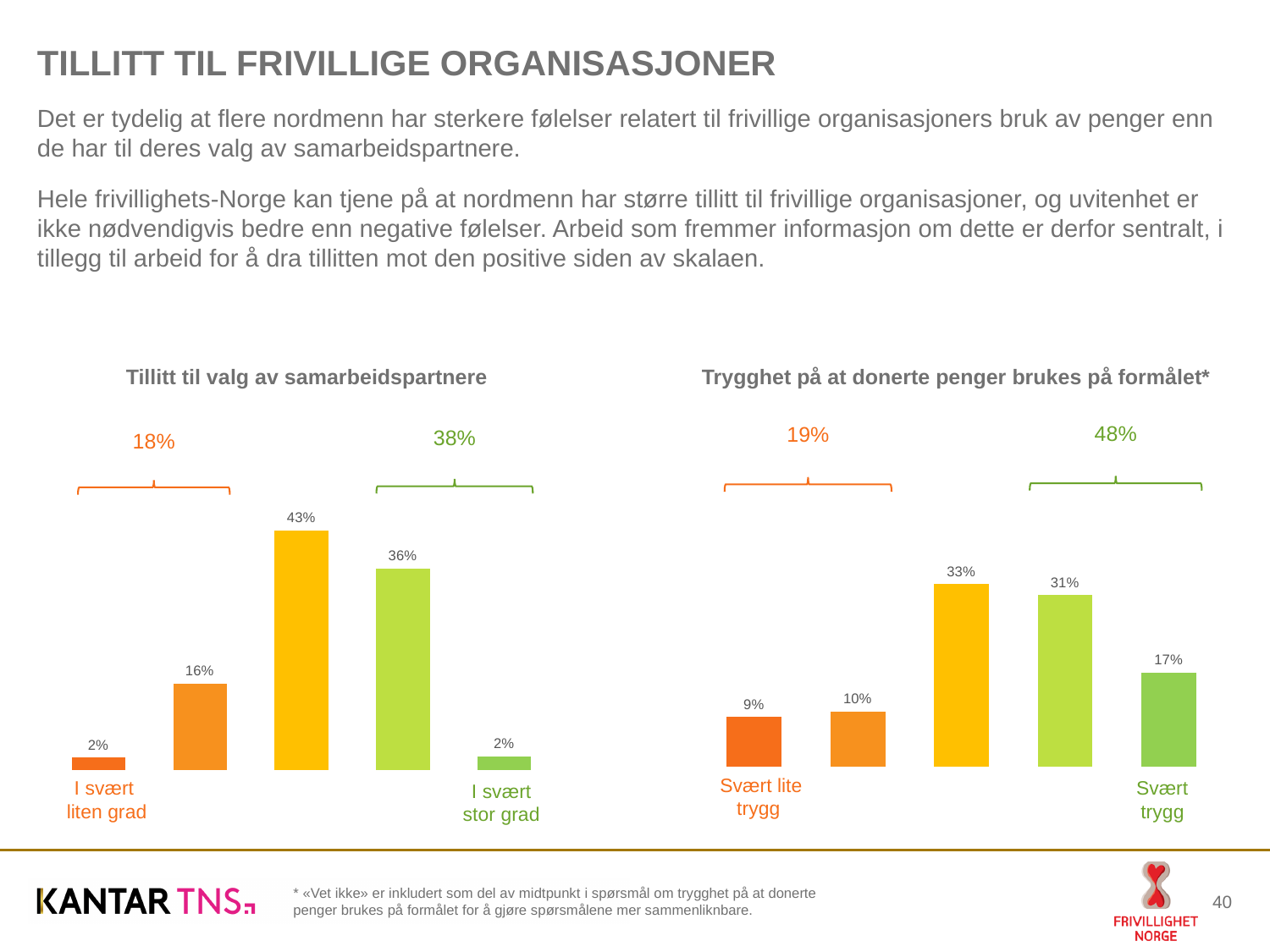
In the chart 'Tillitt til valg av samarbeidspartnere', what combined share is shown by the bracket over the two orange bars on the left? 18% In the chart 'Trygghet på at donerte penger brukes på formålet*', what is the value for 'Svært lite trygg'? 9% In the chart 'Trygghet på at donerte penger brukes på formålet*', what combined share is shown by the bracket over the two green bars on the right? 48% In the chart 'Tillitt til valg av samarbeidspartnere', what is the value of the tallest (middle) bar? 43% Which is larger: 'Svært trygg' in the right chart or 'I svært stor grad' in the left chart? Svært trygg (17%) In the chart 'Tillitt til valg av samarbeidspartnere', what is the value for 'I svært liten grad'? 2% In the chart 'Trygghet på at donerte penger brukes på formålet*', what is the value for 'Svært trygg'? 17% In the chart 'Tillitt til valg av samarbeidspartnere', what combined share is shown by the bracket over the two green bars on the right? 38% In the chart 'Tillitt til valg av samarbeidspartnere', what is the value for 'I svært stor grad'? 2% How many bars does the chart 'Tillitt til valg av samarbeidspartnere' contain? 5 In the chart 'Trygghet på at donerte penger brukes på formålet*', what is the difference between 'Svært trygg' and 'Svært lite trygg'? 8 percentage points In the chart 'Trygghet på at donerte penger brukes på formålet*', which bar has the highest value? The middle (yellow) bar, 33%